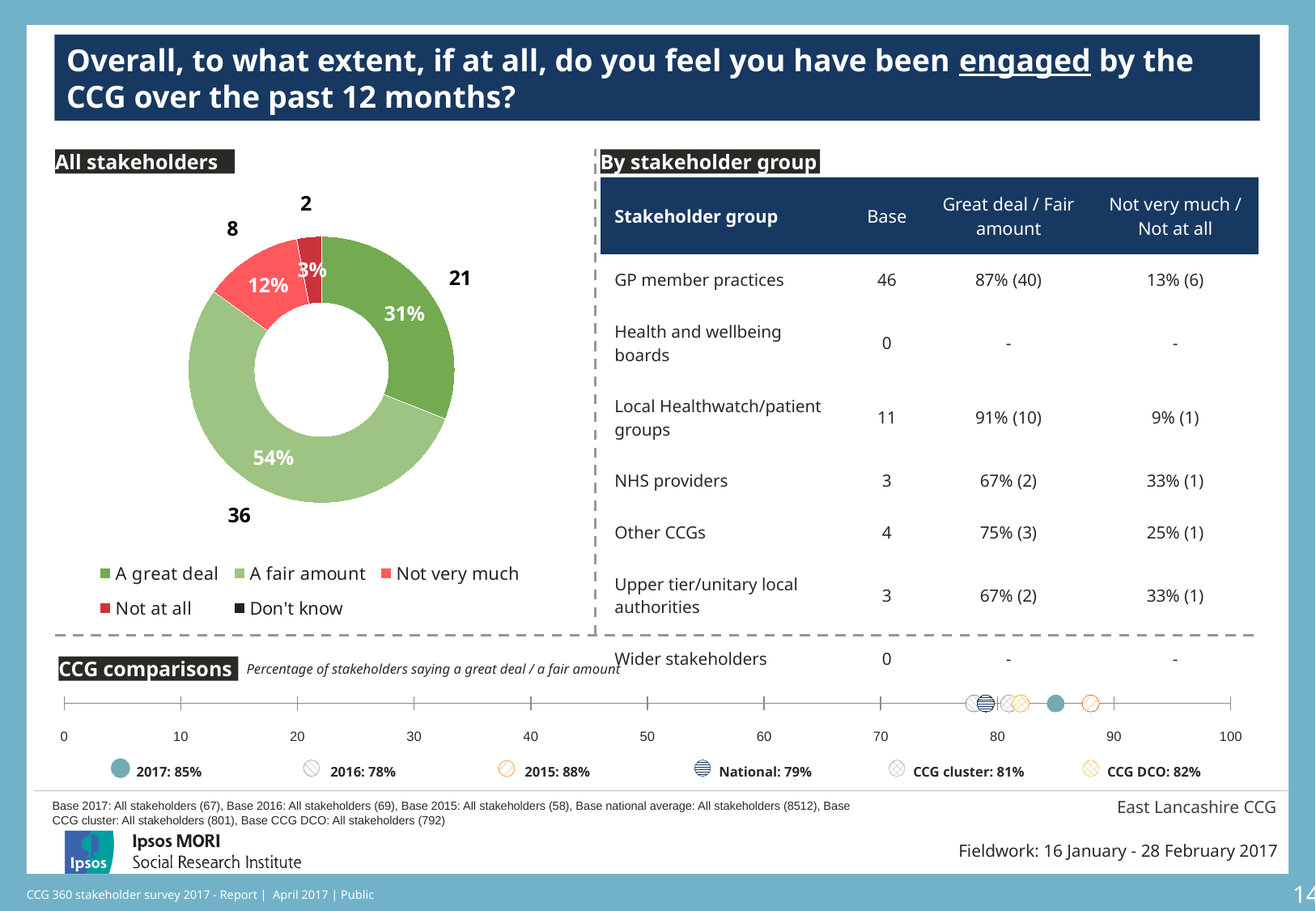
In the All stakeholders chart, which of the plotted responses has the smallest share? Not at all In the All stakeholders chart, which is larger: the share for 'Not very much' or for 'Not at all'? Not very much What type of chart is the All stakeholders chart? Pie chart (donut) In the All stakeholders chart, what percentage of stakeholders said 'A fair amount'? 54% In the CCG comparisons chart, which comparator has the highest value? 2015: 88% In the CCG comparisons chart, what is the difference in percentage points between the 2017 and 2016 values? 7 percentage points In the CCG comparisons chart, what is the 2017 percentage of stakeholders saying a great deal / a fair amount? 85% In the All stakeholders chart, what is the difference in percentage points between 'A fair amount' and 'A great deal'? 23 percentage points In the All stakeholders chart, which response has the largest share? A fair amount In the All stakeholders chart, how many stakeholders said 'A great deal'? 21 How many entries does the legend of the All stakeholders chart list? 5 In the CCG comparisons chart, which comparator has the lowest value? 2016: 78%